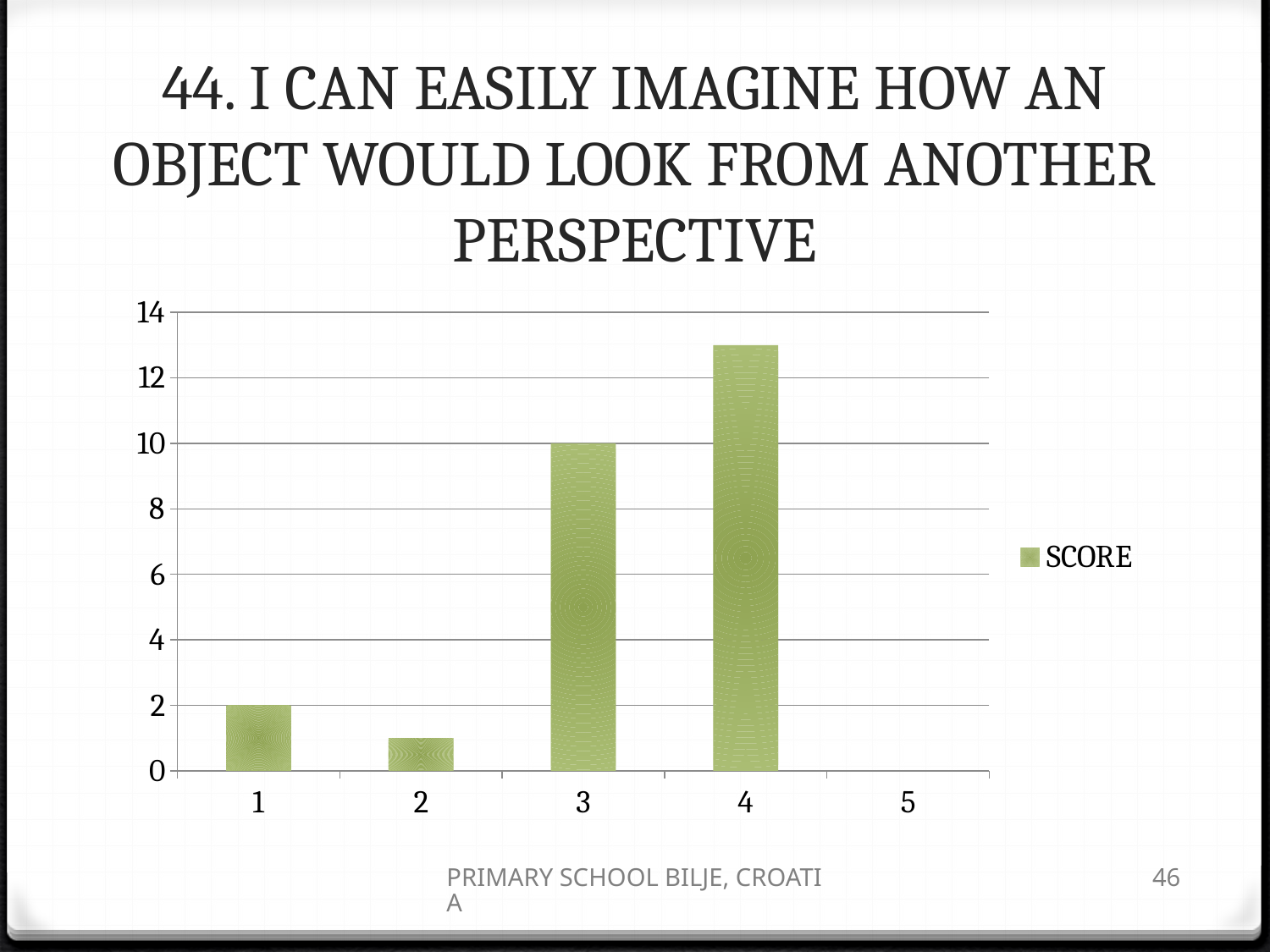
How many series does the legend list? 1 What is the value for category 3? 10 How many categories are shown on the x axis? 5 What kind of chart is shown on the slide? bar chart Which category has the lowest value? 5 What is the value for category 5? 0 Which category has the highest value? 4 Which has a larger value, category 3 or category 4? 4 Is the value for category 2 greater or less than 2? less What is the value for category 1? 2 What is the difference between the values for category 3 and category 1? 8 Is the value for category 4 greater or less than 12? greater